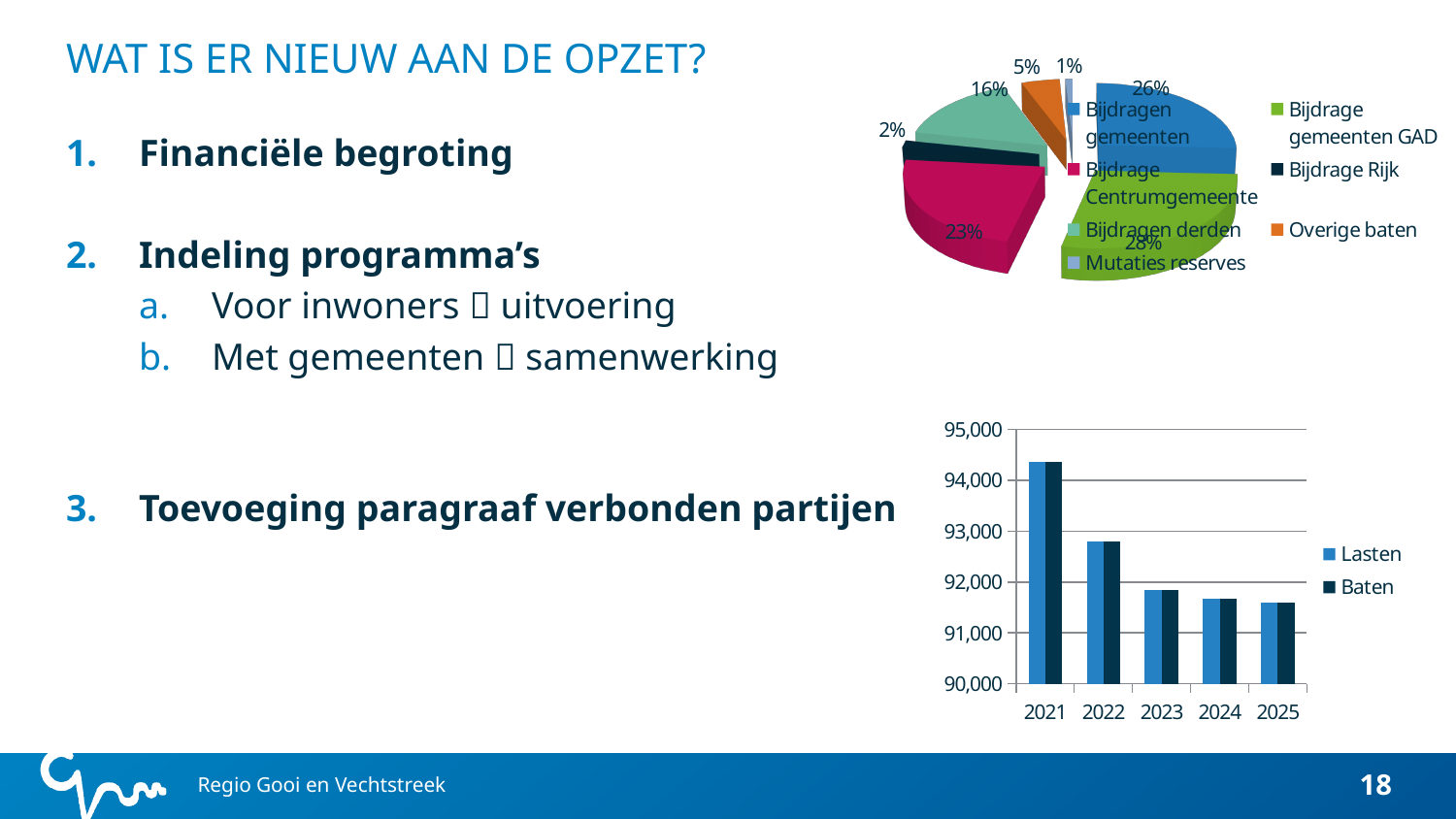
What kind of chart is the chart at the top right of the slide? pie chart In the bar chart at the bottom right, how many years are shown on the x axis? 5 In the bar chart at the bottom right, which year has the highest Lasten value? 2021 In the bar chart at the bottom right, is the Lasten value for 2021 greater or less than 94,000? greater In the bar chart at the bottom right, which is larger: Lasten in 2021 or Lasten in 2023? Lasten in 2021 In the pie chart at the top right, what is the largest percentage shown on any slice? 28% In the bar chart at the bottom right, how many series does the legend list? 2 In the bar chart at the bottom right, is the Lasten value for 2025 greater or less than 92,000? less What kind of chart is the chart at the bottom right of the slide? bar chart In the bar chart at the bottom right, do the Lasten values rise or fall from 2021 to 2025? fall In the bar chart at the bottom right, is the Baten value for 2022 greater or less than 93,000? less In the pie chart at the top right, what is the smallest percentage shown on any slice? 1%